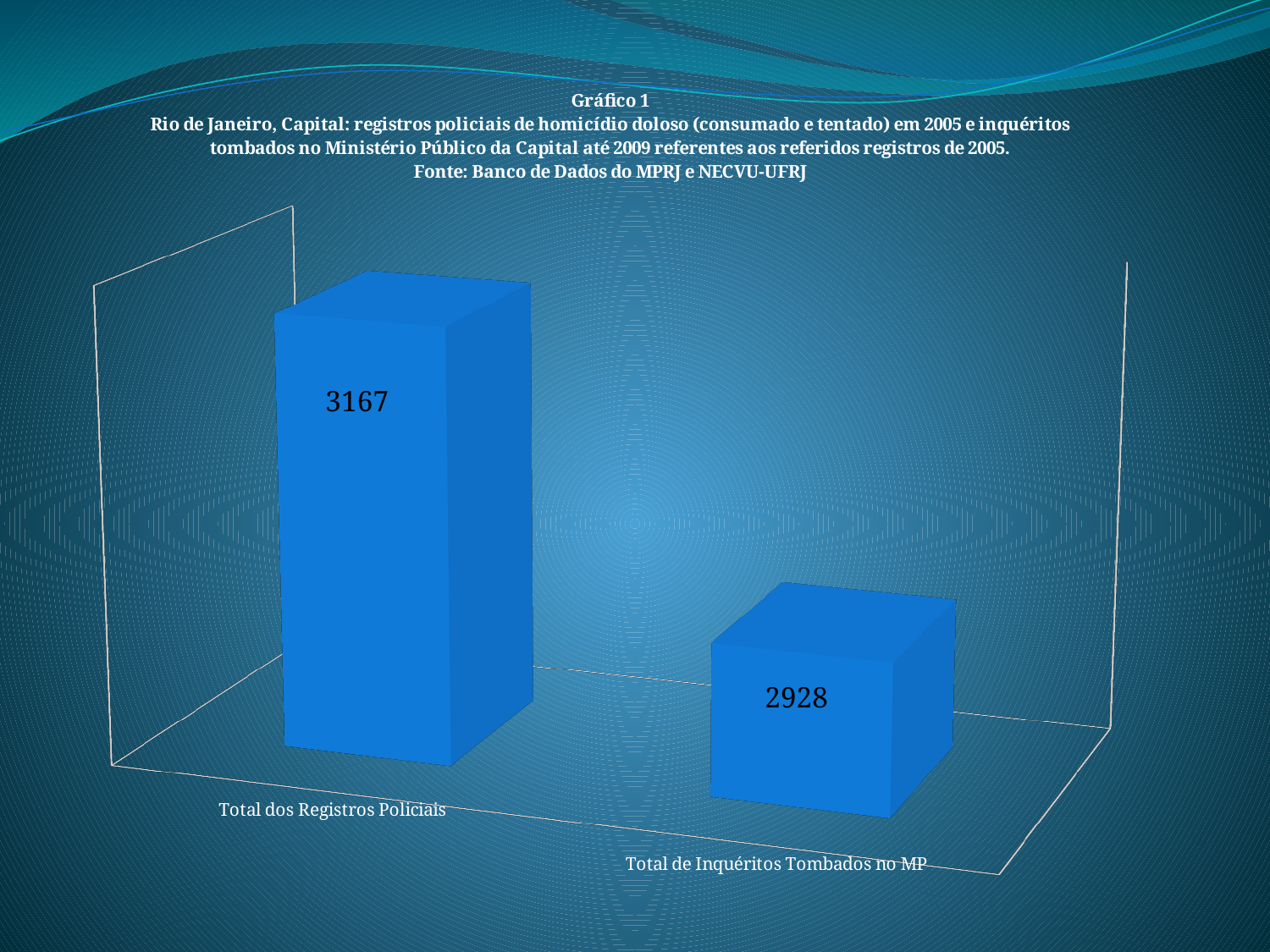
Which category has the highest value? Total dos Registros Policiais Which category has the lowest value? Total de Inquéritos Tombados no MP What source is cited for the chart data? Banco de Dados do MPRJ e NECVU-UFRJ What is the chart number given in the title? Gráfico 1 What is the difference between Total dos Registros Policiais and Total de Inquéritos Tombados no MP? 239 What is the value for Total dos Registros Policiais? 3167 What kind of chart is shown on the slide? Bar chart What is the value for Total de Inquéritos Tombados no MP? 2928 Do the values rise or fall from the first category to the second? Fall Which is larger, Total dos Registros Policiais or Total de Inquéritos Tombados no MP? Total dos Registros Policiais How many categories are shown in the chart? 2